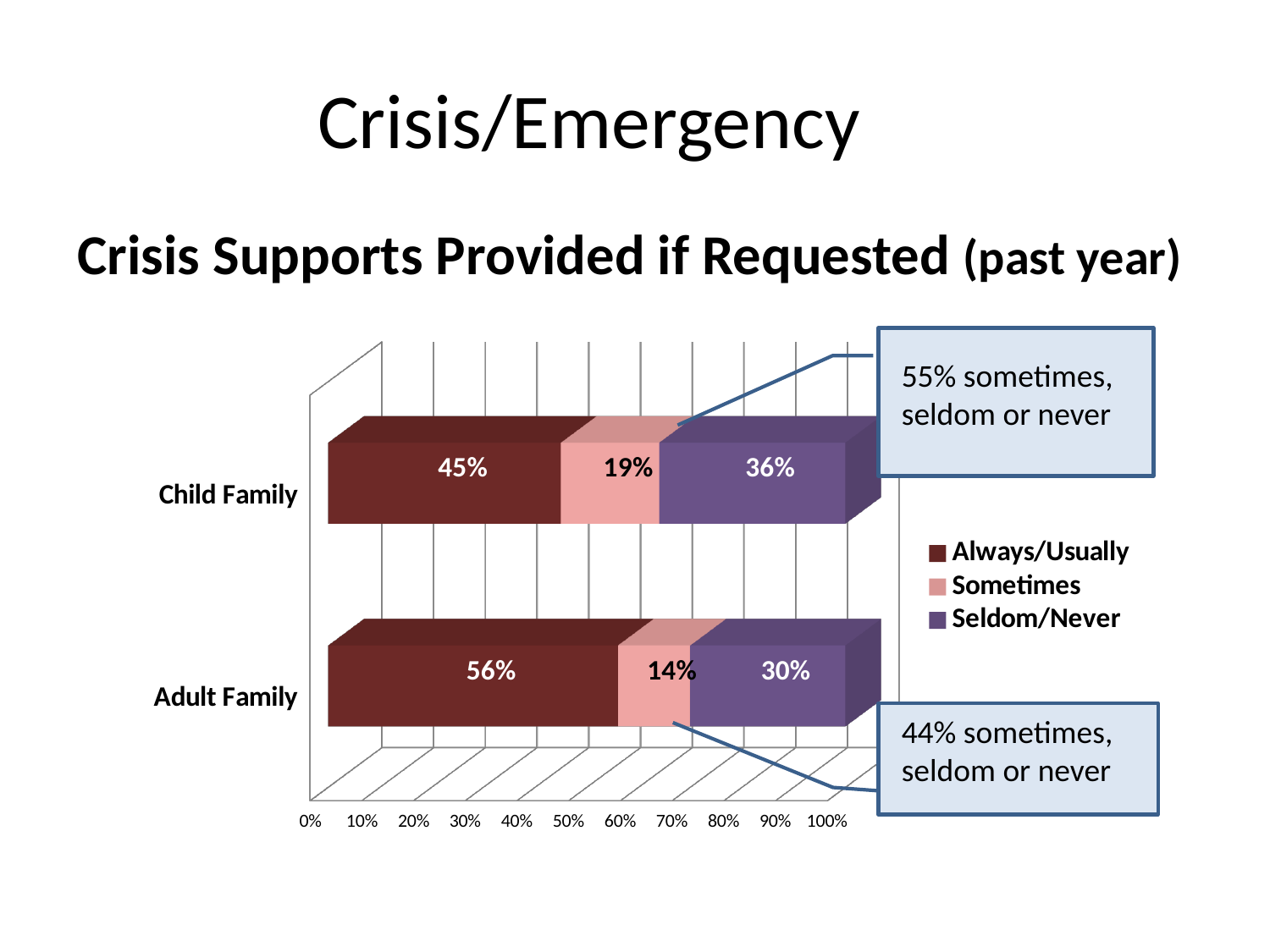
Which category has the higher Always/Usually value, Child Family or Adult Family? Adult Family What is the difference between the Always/Usually values for Adult Family and Child Family? 11% What is the Seldom/Never value for Child Family? 36% What percentage of Child Family respondents reported crisis supports were Always/Usually provided if requested? 45% How many categories are shown on the chart? 2 According to the callout, what percentage of Child Family respondents said sometimes, seldom or never? 55% What is the Sometimes value for Adult Family? 14% What is the difference between the Seldom/Never values for Child Family and Adult Family? 6% What is the Always/Usually value for Adult Family? 56% What kind of chart is shown on the slide? Stacked bar chart How many series does the legend list? 3 Which category has the higher Seldom/Never value? Child Family